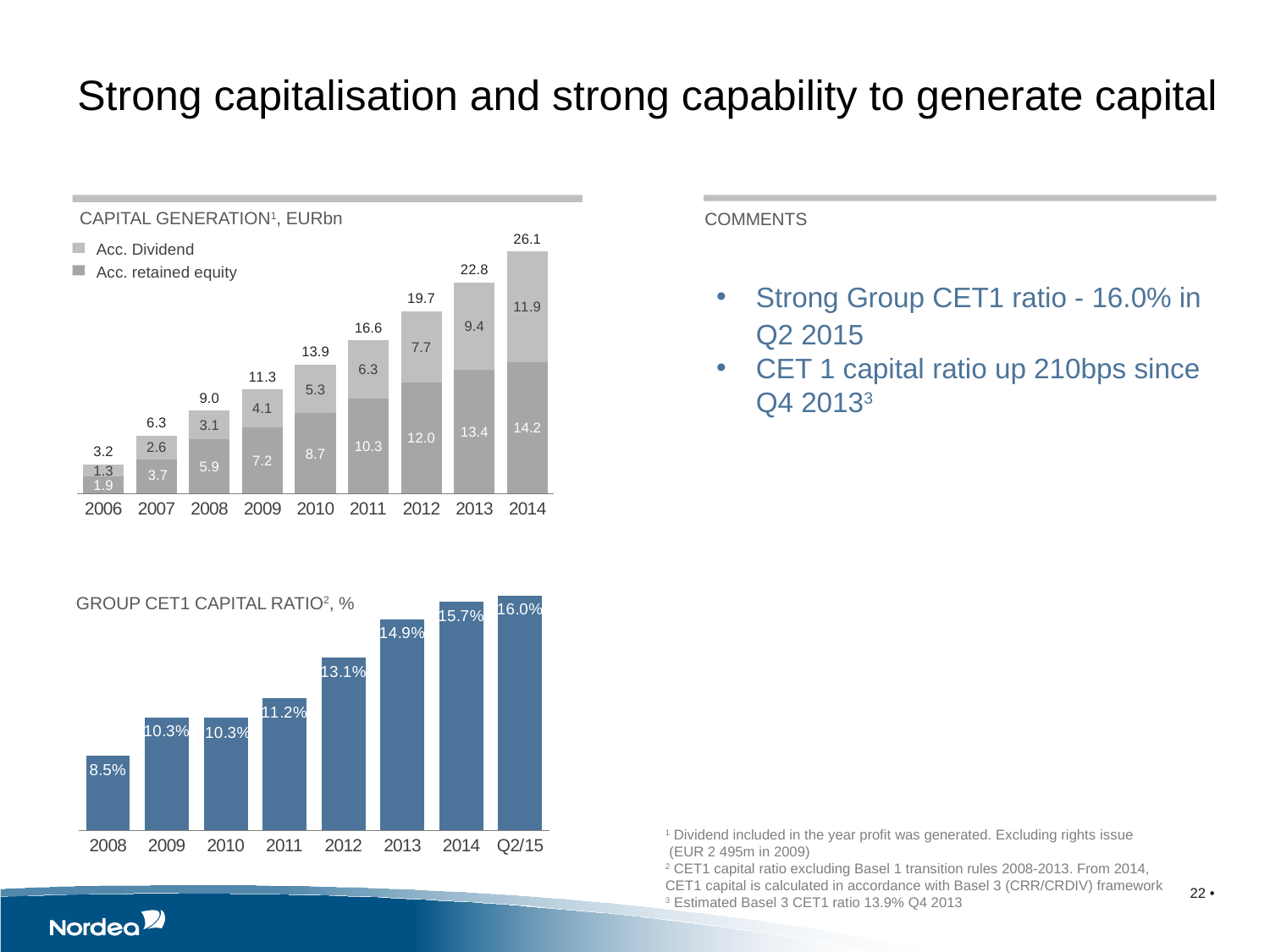
In the CAPITAL GENERATION chart, what is the Acc. Dividend value for 2013? 9.4 What kind of chart is the GROUP CET1 CAPITAL RATIO chart? bar chart In the GROUP CET1 CAPITAL RATIO chart, what is the value for 2013? 14.9% In the GROUP CET1 CAPITAL RATIO chart, what is the difference between the values for 2012 and 2011? 1.9% In the CAPITAL GENERATION chart, what is the total capital generation shown for 2014? 26.1 In the CAPITAL GENERATION chart, how many series does the legend list? 2 In the CAPITAL GENERATION chart, which year has the lowest total? 2006 In the CAPITAL GENERATION chart, what is the difference between the totals for 2014 and 2013? 3.3 In the GROUP CET1 CAPITAL RATIO chart, which period has the highest value? Q2/15 In the CAPITAL GENERATION chart, how many years are shown on the x axis? 9 In the CAPITAL GENERATION chart, do the totals rise or fall from 2006 to 2014? rise In the CAPITAL GENERATION chart, what is the Acc. retained equity value for 2012? 12.0